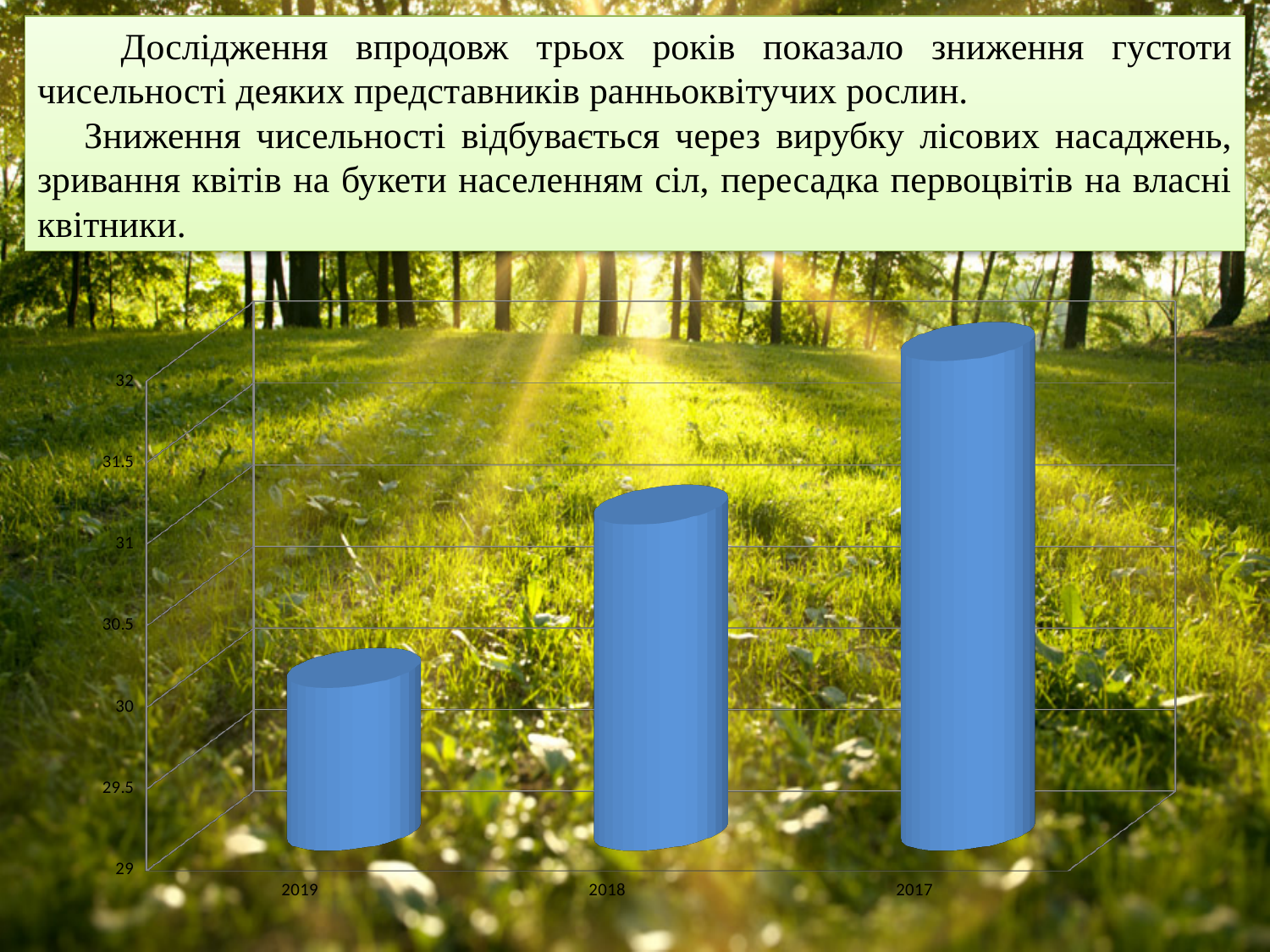
Is the value for 2019 greater or less than 31? less Is the value for 2018 greater or less than 30.5? greater What kind of chart is shown on the slide? bar chart Which is larger, the value for 2018 or the value for 2019? 2018 How many categories (years) are plotted on the chart? 3 Which year has the lowest bar on the chart? 2019 Do the bar values rise or fall moving left to right along the x axis from 2019 to 2017? rise Which year has the highest bar on the chart? 2017 Which is larger, the value for 2017 or the value for 2018? 2017 What is the lowest value shown on the vertical axis of the chart? 29 What is the highest value shown on the vertical axis of the chart? 32 Is the value for 2017 greater or less than 31? greater